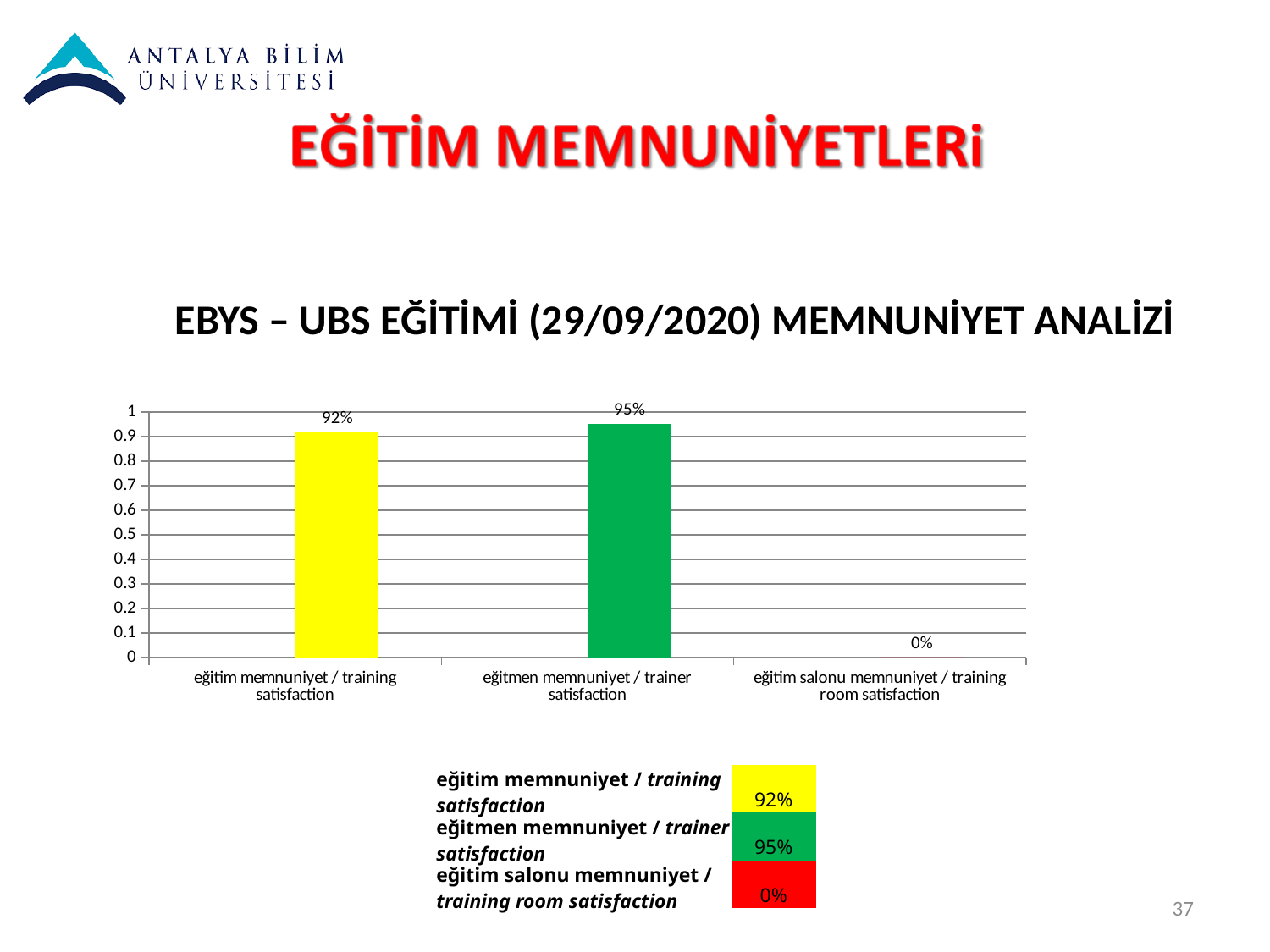
Is the value for eğitim memnuniyet / training satisfaction greater or less than 0.5? greater How many categories are shown on the x axis? 3 What is the difference between the trainer satisfaction value and the training satisfaction value? 3% What is the value for eğitim memnuniyet / training satisfaction? 92% What kind of chart is shown on the slide? bar chart What is the title of the chart? EBYS – UBS EĞİTİMİ (29/09/2020) MEMNUNİYET ANALİZİ Which is larger, the value for training satisfaction or the value for trainer satisfaction? trainer satisfaction Which category has the highest value? eğitmen memnuniyet / trainer satisfaction What is the value for eğitmen memnuniyet / trainer satisfaction? 95% Which category has the lowest value? eğitim salonu memnuniyet / training room satisfaction What is the value for eğitim salonu memnuniyet / training room satisfaction? 0% What colour is the bar for eğitmen memnuniyet / trainer satisfaction? green